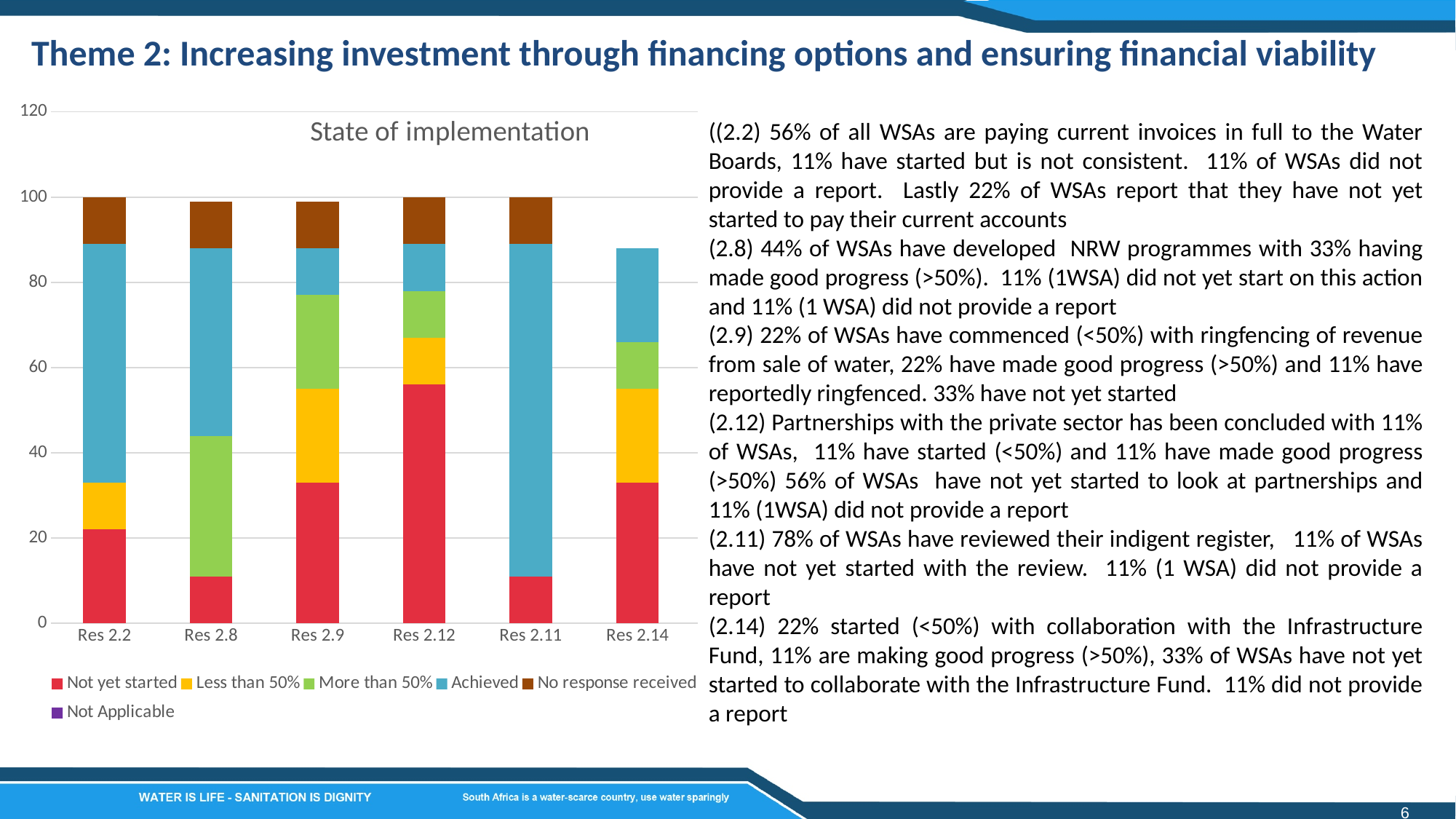
Which category's bar has no 'No response received' segment? Res 2.14 How many categories (Res items) are shown on the x axis of the chart? 6 Which has a larger 'Achieved' segment, Res 2.11 or Res 2.12? Res 2.11 Is the 'Not yet started' value for Res 2.11 greater or less than 20? less Which category has the largest 'More than 50%' segment? Res 2.8 How many bars include a 'More than 50%' segment? 4 What is the title of the chart? State of implementation How many series does the chart legend list? 6 What kind of chart is shown on the slide? Stacked bar chart Is the 'Not yet started' value for Res 2.12 greater or less than 40? greater Is the total height of the Res 2.14 bar greater or less than 100? less Which category has the largest 'Not yet started' segment? Res 2.12